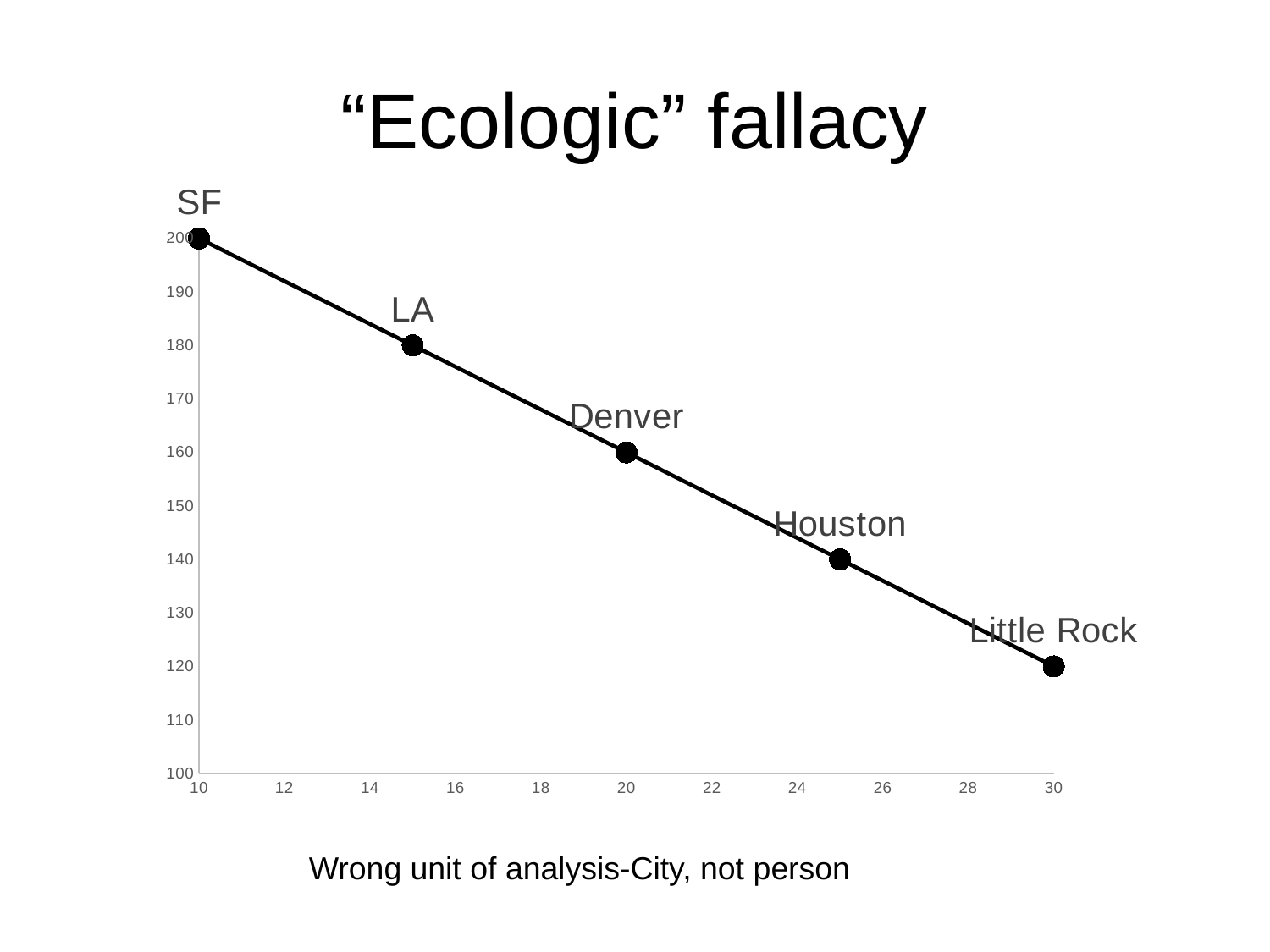
Which has the larger y-axis value, Denver or Houston? Denver What is the y-axis value for the point labelled SF? 200 What is the title of the slide containing the chart? "Ecologic" fallacy Is the y-axis value for LA greater or less than 150? greater What is the y-axis value for the point labelled Little Rock? 120 Do the y-axis values rise or fall as the x-axis value increases? fall How many labelled data points are plotted on the chart? 5 Which labelled point has the highest y-axis value? SF Which labelled point has the lowest y-axis value? Little Rock What is the y-axis value for the point labelled Denver? 160 What is the difference between the y-axis values for LA and Houston? 40